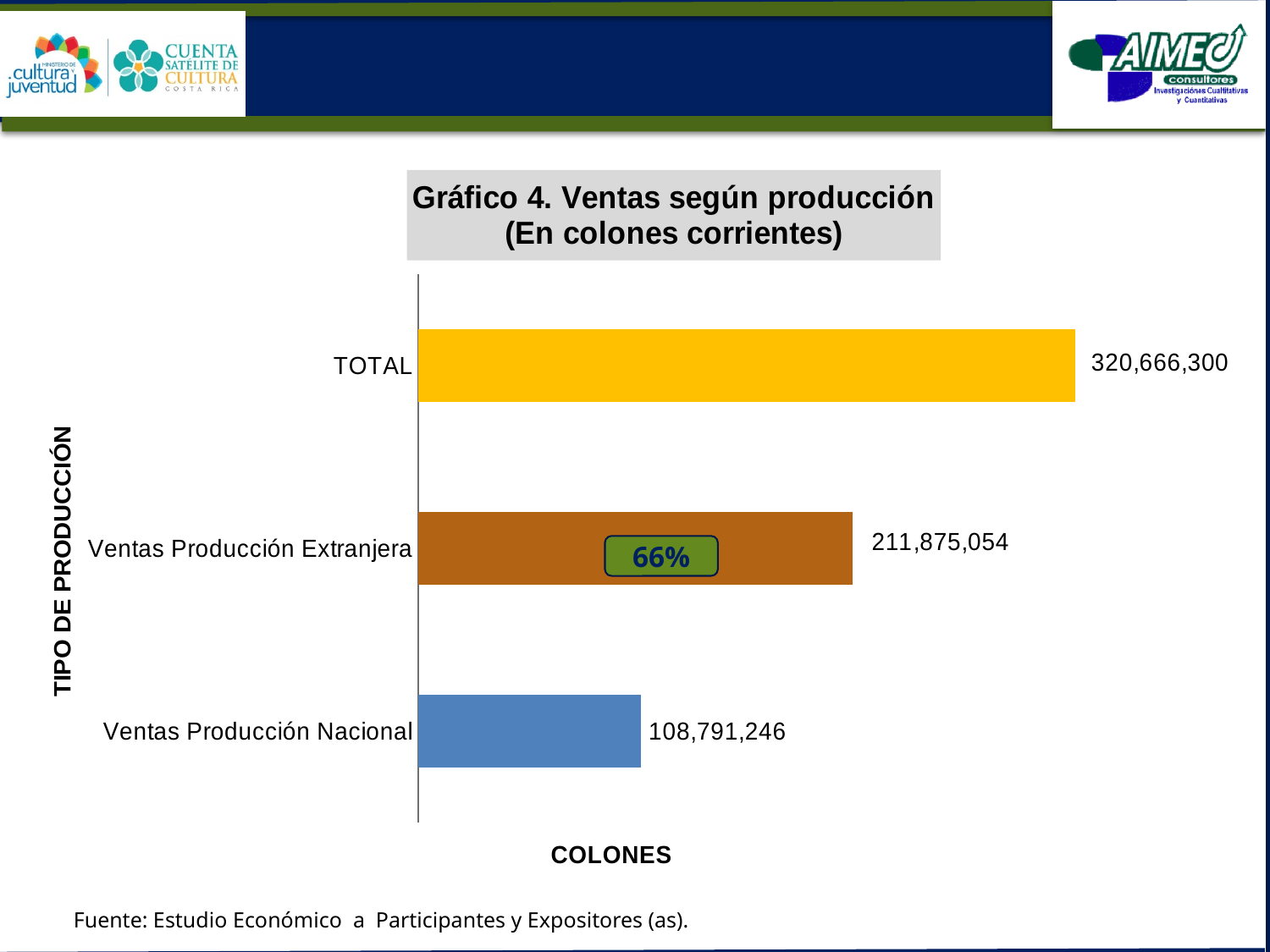
What is the value for Ventas Producción Nacional? 108,791,246 What is the label of the horizontal axis? COLONES Which category has the highest value? TOTAL What is the value for TOTAL? 320,666,300 What is the value for Ventas Producción Extranjera? 211,875,054 What percentage is shown in the label on the Ventas Producción Extranjera bar? 66% How many bars are shown in the chart? 3 Which is larger, Ventas Producción Extranjera or Ventas Producción Nacional? Ventas Producción Extranjera What kind of chart is this? Bar chart What is the title of the chart? Gráfico 4. Ventas según producción (En colones corrientes) What is the difference between Ventas Producción Extranjera and Ventas Producción Nacional? 103,083,808 Which category has the lowest value? Ventas Producción Nacional